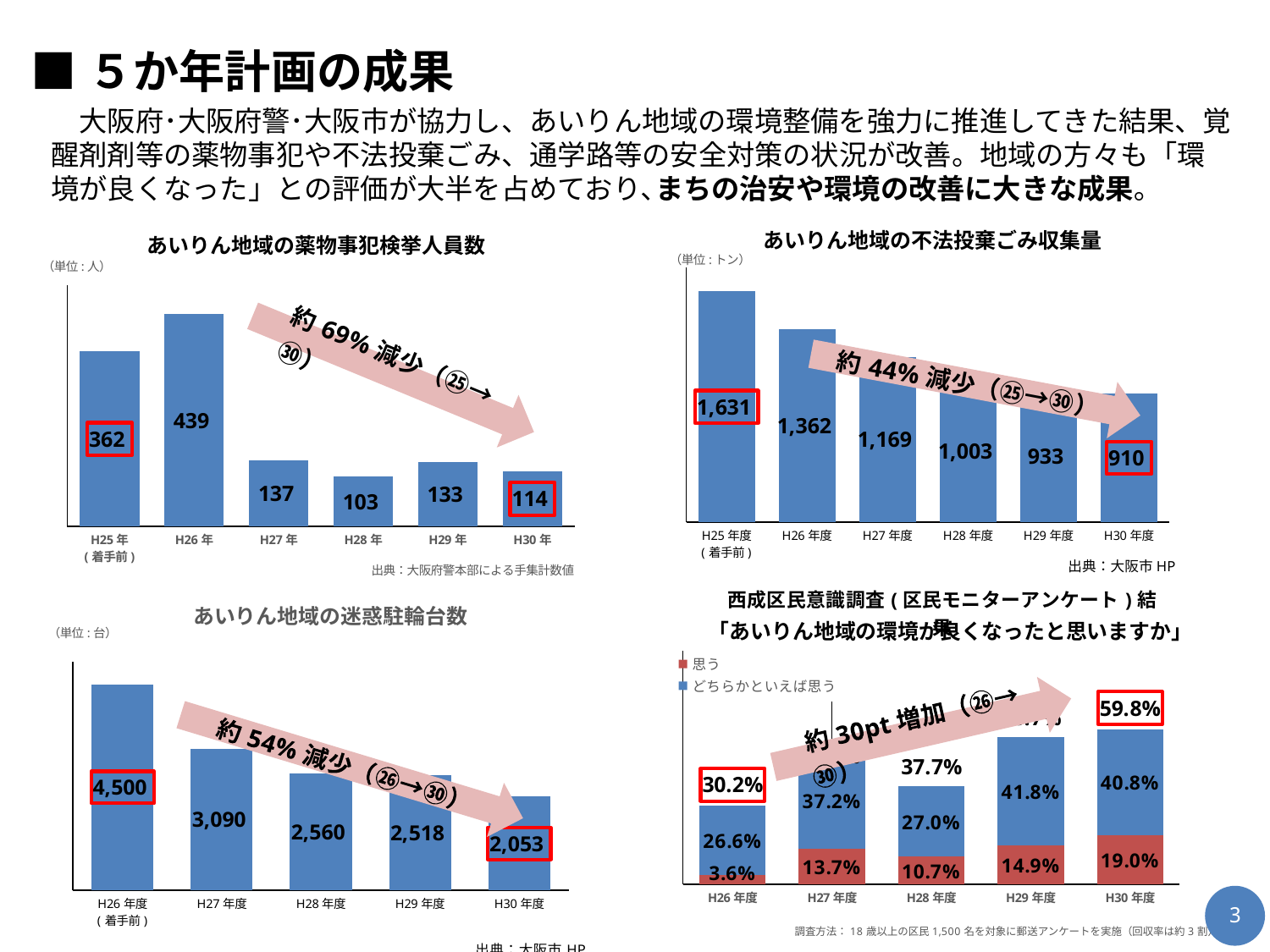
In the chart titled あいりん地域の薬物事犯検挙人員数, what is the difference between the H25年 value and the H30年 value? 248 In the chart titled あいりん地域の迷惑駐輪台数, how many years are plotted? 5 In the bottom-right chart (西成区民意識調査), what is the total of the stacked bar for H26年度? 30.2% In the chart titled あいりん地域の迷惑駐輪台数, which is larger, the value for H28年度 or the value for H29年度? H28年度 In the chart titled あいりん地域の迷惑駐輪台数, what is the value for H27年度? 3,090 In the chart titled あいりん地域の薬物事犯検挙人員数, what is the value for H26年? 439 In the chart titled あいりん地域の不法投棄ごみ収集量, which year has the highest value? H25年度 In the chart titled あいりん地域の不法投棄ごみ収集量, what is the value for H28年度? 1,003 In the bottom-right chart (西成区民意識調査), how many series does the legend list? 2 In the bottom-right chart (西成区民意識調査), what is the 思う value for H30年度? 19.0% In the chart titled あいりん地域の不法投棄ごみ収集量, do the values rise or fall from H25年度 to H30年度? fall In the chart titled あいりん地域の薬物事犯検挙人員数, which year has the lowest value? H28年